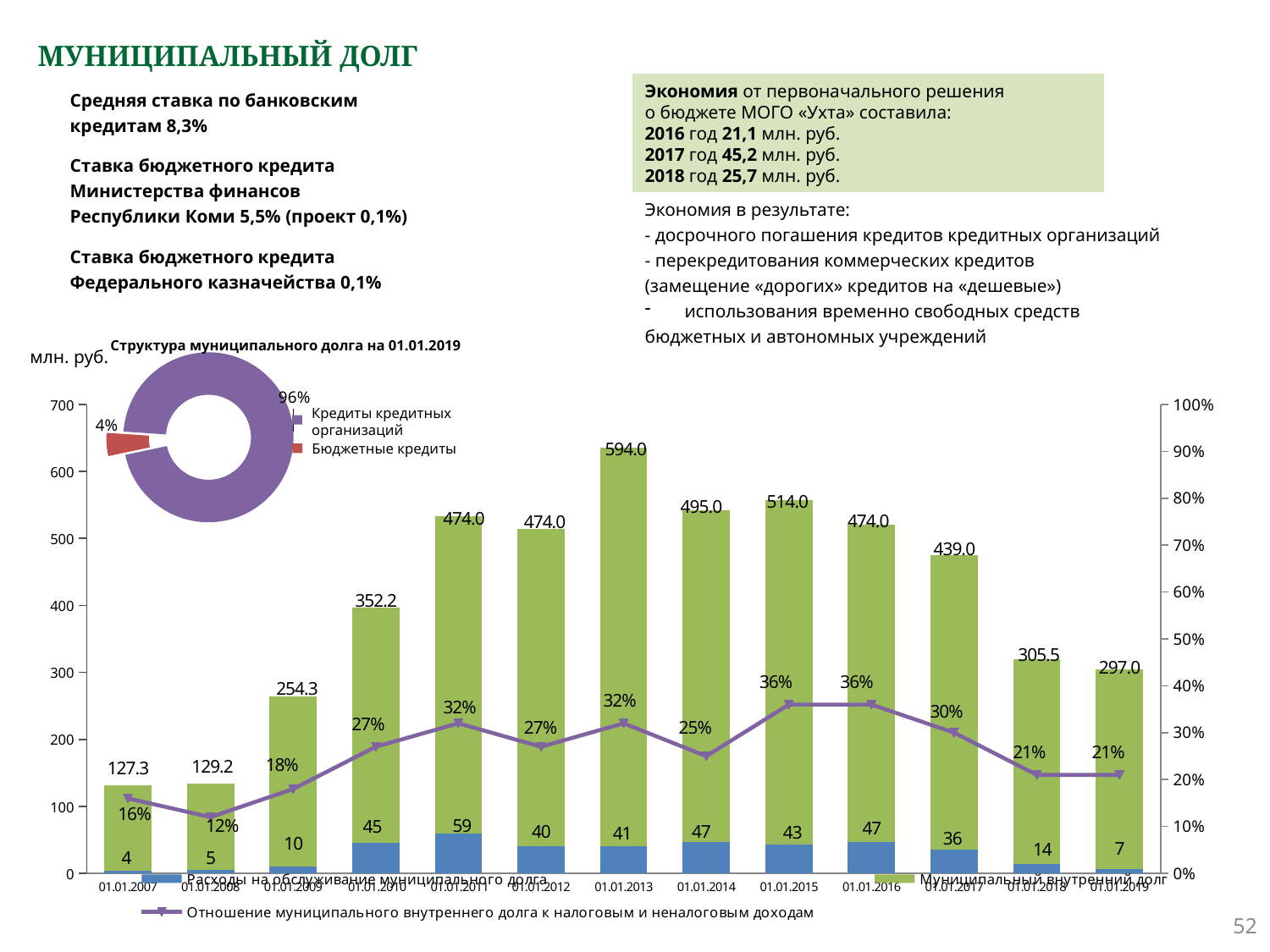
In the bar chart, on which date is Муниципальный внутренний долг lowest? 01.01.2007 How many dates are shown on the x axis of the bar chart? 13 What kind of chart is the chart titled Структура муниципального долга на 01.01.2019? doughnut chart In the bar chart, does Муниципальный внутренний долг rise or fall from 01.01.2016 to 01.01.2019? fall In the bar chart, what is the value of Расходы на обслуживание муниципального долга on 01.01.2011? 59 In the bar chart, what is the difference in Муниципальный внутренний долг between 01.01.2013 and 01.01.2019? 297.0 In the bar chart, on which date is Муниципальный внутренний долг highest? 01.01.2013 In the chart titled Структура муниципального долга на 01.01.2019, what share is Бюджетные кредиты? 4% In the bar chart, what is the value of Отношение муниципального внутреннего долга к налоговым и неналоговым доходам on 01.01.2015? 36% In the bar chart, what is the value of Муниципальный внутренний долг on 01.01.2013? 594.0 How many series does the legend of the bar chart list? 3 In the bar chart, which is larger: Муниципальный внутренний долг on 01.01.2010 or on 01.01.2018? 01.01.2010